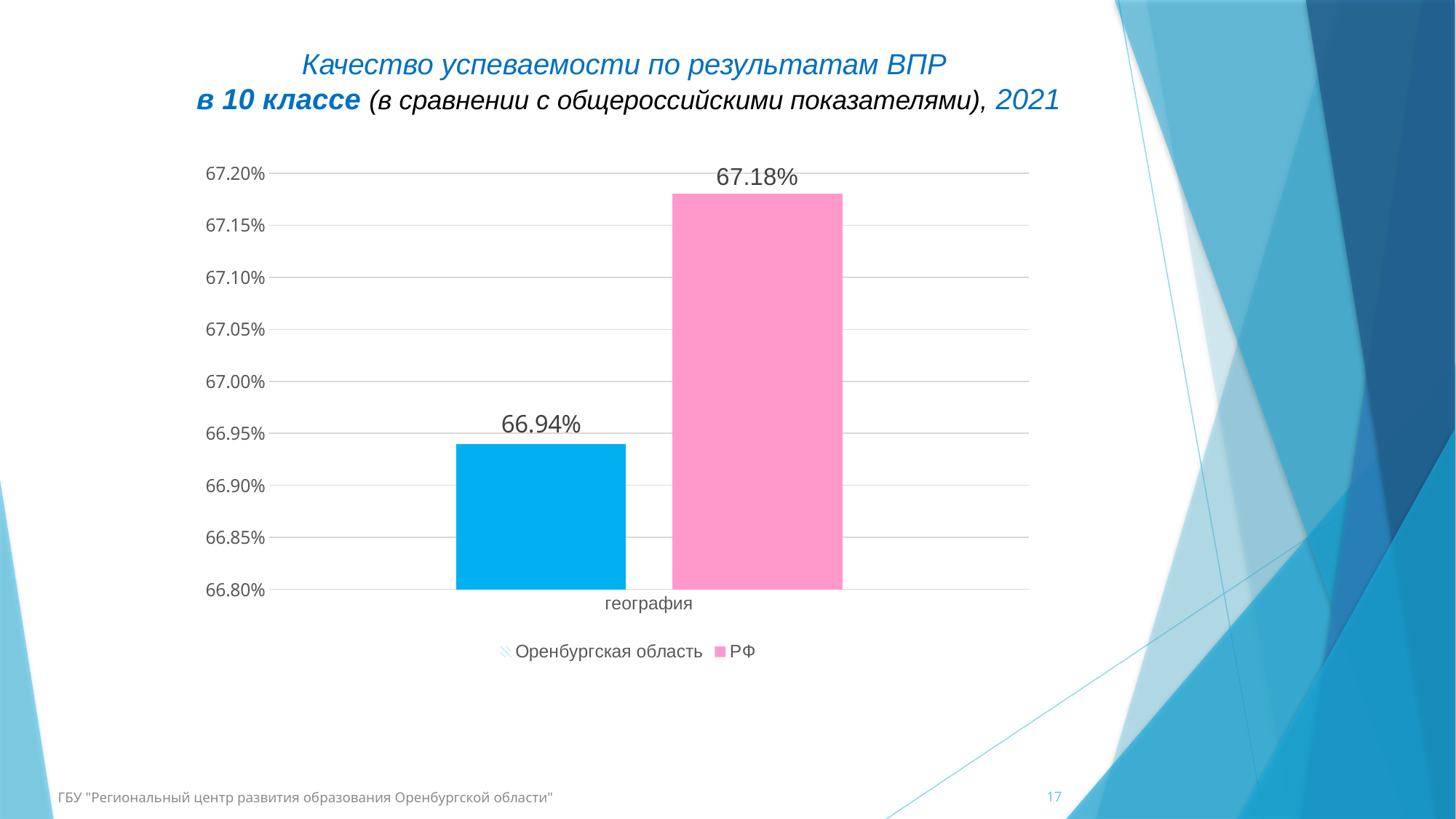
Is the value for РФ greater or less than 67.00%? greater What category label is shown on the x axis? география Which series has the higher value for география, Оренбургская область or РФ? РФ What is the value for РФ in география? 67.18% How many categories are shown on the x axis? 1 How many series does the legend list? 2 What colour is the bar for РФ? pink Is the value for Оренбургская область greater or less than 67.00%? less What kind of chart is shown on the slide? bar chart Which series has the lowest value on the chart? Оренбургская область What is the difference between the РФ value and the Оренбургская область value for география? 0.24% What is the value for Оренбургская область in география? 66.94%